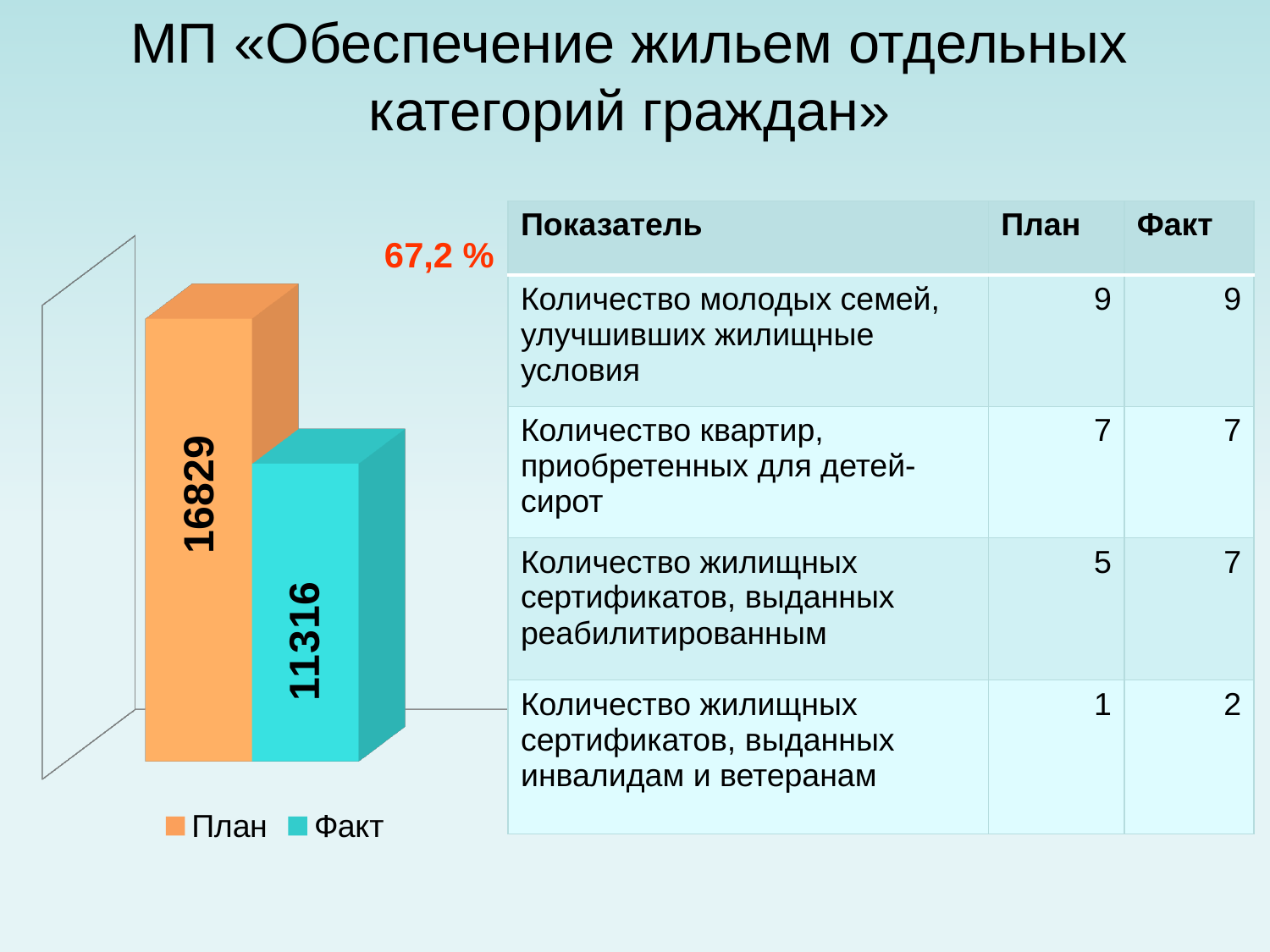
What percentage is printed above the bars in the chart? 67,2 % What is the value of the План bar in the chart? 16829 What colour is the Факт bar in the chart? teal How many series does the chart legend list? 2 What kind of chart is shown on the slide? bar chart How many bars are plotted in the chart? 2 What is the difference between the План and Факт values in the chart? 5513 Which bar in the chart is the lowest? Факт Which series has the higher bar in the chart, План or Факт? План Which bar in the chart is the highest? План What is the value of the Факт bar in the chart? 11316